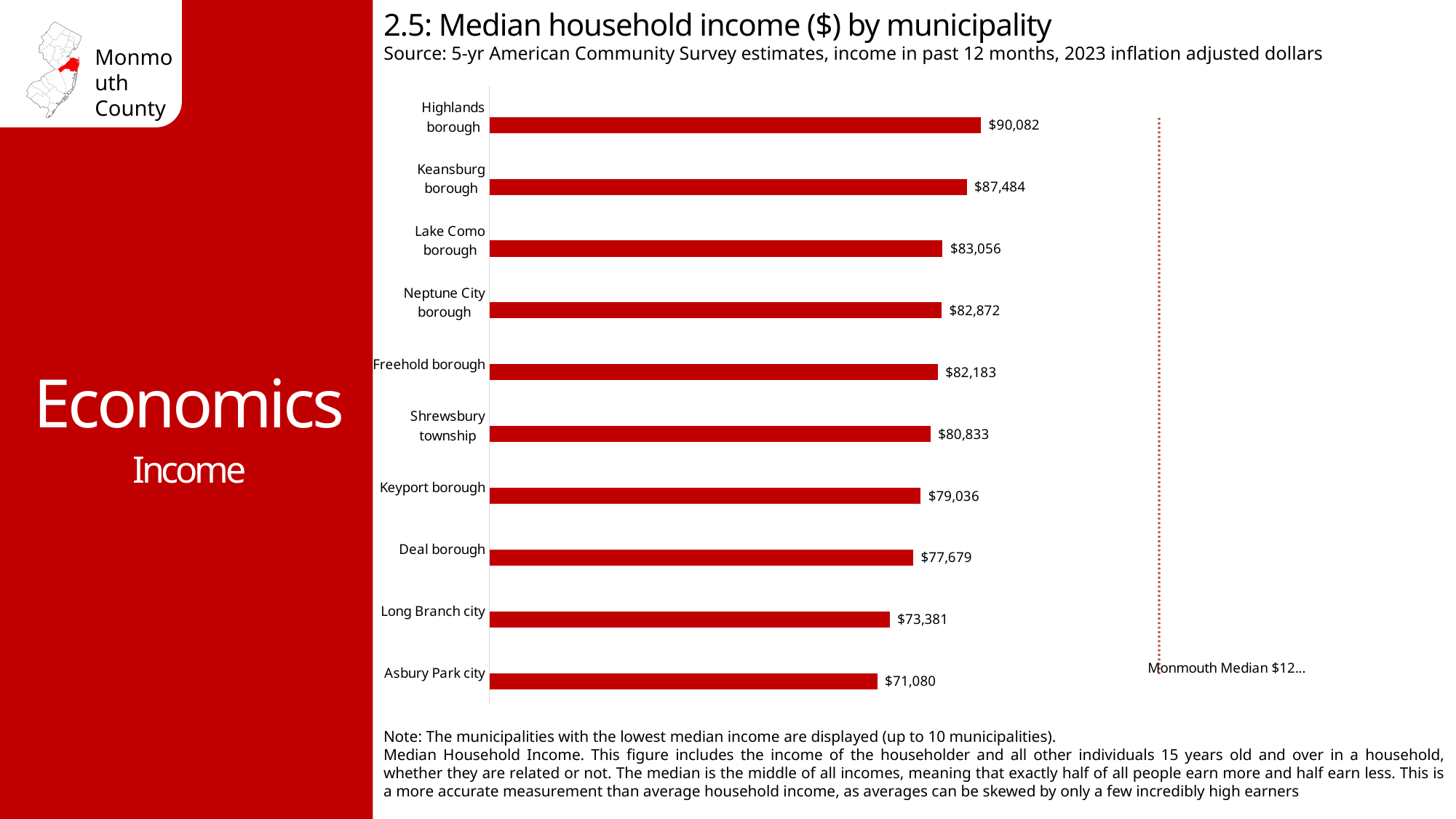
What is the median household income for Keyport borough? $79,036 What type of chart is used on this slide? Bar chart Which municipality has the highest median household income shown on the chart? Highlands borough Which municipality has the lowest median household income shown on the chart? Asbury Park city How many municipalities are shown on the chart? 10 What is the difference in median household income between Keansburg borough and Long Branch city? $14,103 What is the title of the chart? 2.5: Median household income ($) by municipality What is the median household income for Shrewsbury township? $80,833 What is the difference in median household income between Highlands borough and Asbury Park city? $19,002 What is the median household income for Asbury Park city? $71,080 Which has a higher median household income, Deal borough or Long Branch city? Deal borough What is the median household income for Highlands borough? $90,082